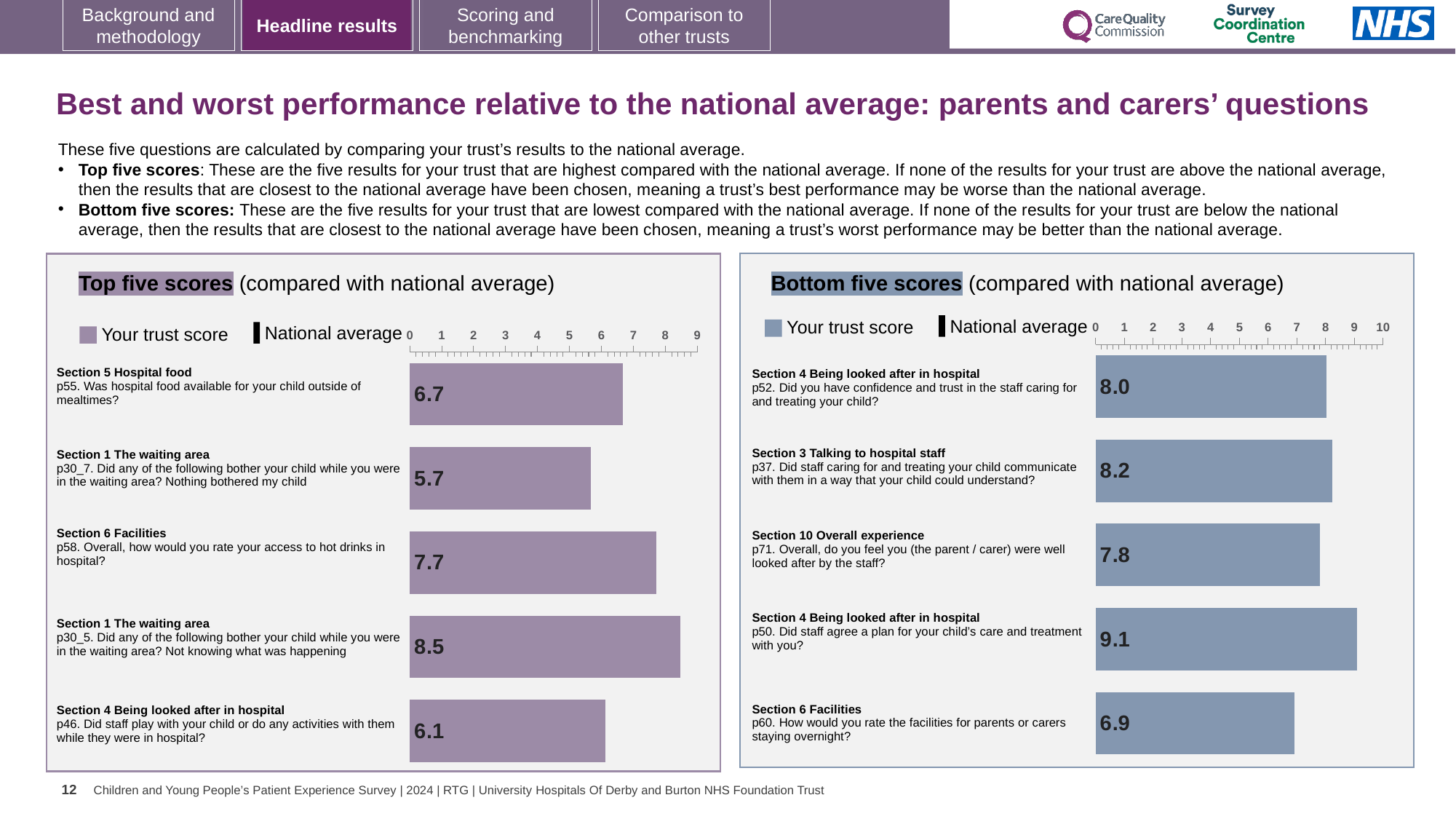
In the 'Top five scores' chart, what is the difference between the trust scores for p30_5 and p30_7? 2.8 In the 'Bottom five scores' chart, what is the trust score for p60 (How would you rate the facilities for parents or carers staying overnight)? 6.9 How many bars are shown in the 'Top five scores' chart? 5 In the 'Top five scores' chart, which question has the highest trust score? p30_5. Did any of the following bother your child while you were in the waiting area? Not knowing what was happening What type of chart is the 'Bottom five scores' chart? Bar chart In the 'Top five scores' chart, which question has the lowest trust score? p30_7. Did any of the following bother your child while you were in the waiting area? Nothing bothered my child In the 'Bottom five scores' chart, which question has the lowest trust score? p60. How would you rate the facilities for parents or carers staying overnight? In the 'Bottom five scores' chart, which question has the highest trust score? p50. Did staff agree a plan for your child's care and treatment with you? In the 'Bottom five scores' chart, which has the larger trust score: p52 or p71? p52 How many entries does the legend of the 'Top five scores' chart list? 2 In the 'Bottom five scores' chart, what is the difference between the trust scores for p50 and p60? 2.2 In the 'Top five scores' chart, what is the trust score for p55 (Was hospital food available for your child outside of mealtimes)? 6.7